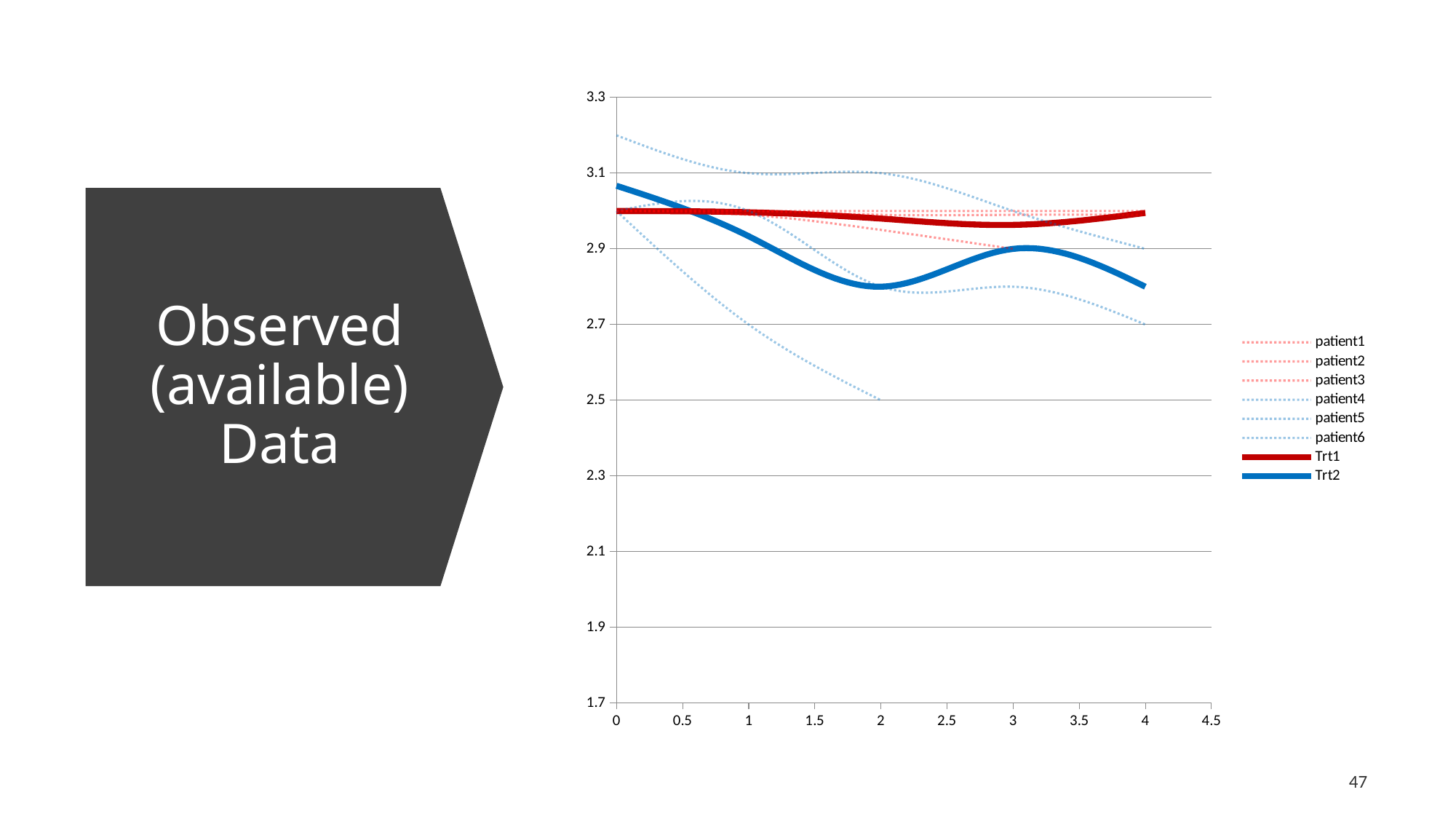
Does the Trt2 line rise or fall overall from x = 0 to x = 4? fall At x = 4, which is higher, Trt1 or Trt2? Trt1 How many series does the chart legend list? 8 At x = 4, is the value for Trt2 greater or less than 2.9? less What kind of chart is shown on the slide? line chart At x = 2, which is higher, Trt1 or Trt2? Trt1 What colour is the Trt1 line in the legend? red At x = 2, is the value for Trt2 greater or less than 2.9? less What is the highest value shown on the y axis? 3.3 Which series reaches the lowest value on the chart? patient6 At x = 2, is the value for patient6 greater or less than 2.7? less